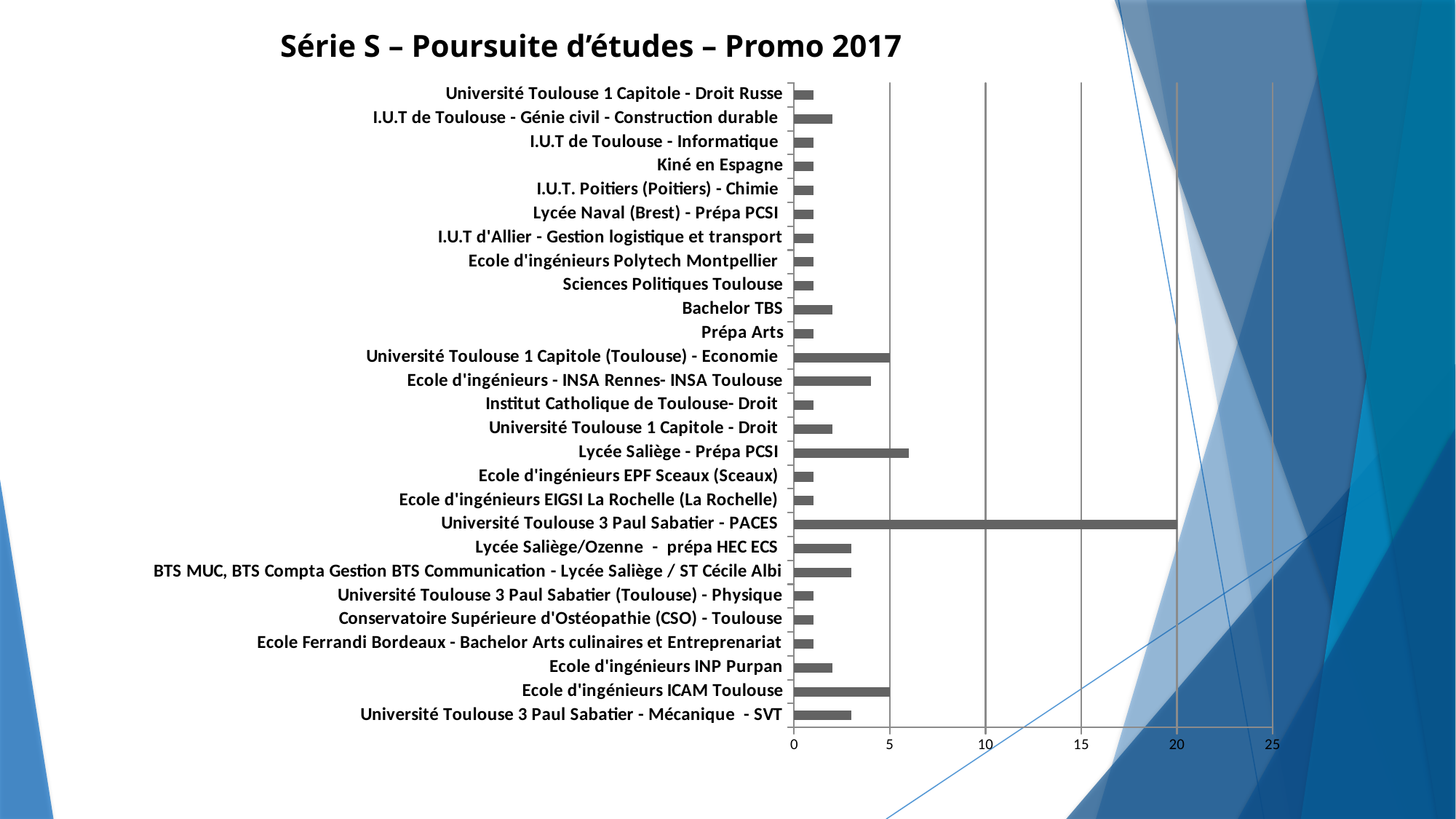
What is the title of the chart? Série S – Poursuite d'études – Promo 2017 What is the highest value shown on the horizontal axis? 25 What kind of chart is shown on the slide? bar chart Is the value for Ecole d'ingénieurs - INSA Rennes- INSA Toulouse greater or less than 5? less What is the difference between the values for Université Toulouse 3 Paul Sabatier - PACES and Ecole d'ingénieurs ICAM Toulouse? 15 Is the value for Lycée Saliège - Prépa PCSI greater or less than 5? greater How many categories are shown in the chart? 27 What is the value for Université Toulouse 1 Capitole (Toulouse) - Economie? 5 What is the value for Ecole d'ingénieurs ICAM Toulouse? 5 What is the value for Université Toulouse 3 Paul Sabatier - PACES? 20 Which is larger, the value for Lycée Saliège - Prépa PCSI or the value for Ecole d'ingénieurs - INSA Rennes- INSA Toulouse? Lycée Saliège - Prépa PCSI Which category has the highest value? Université Toulouse 3 Paul Sabatier - PACES